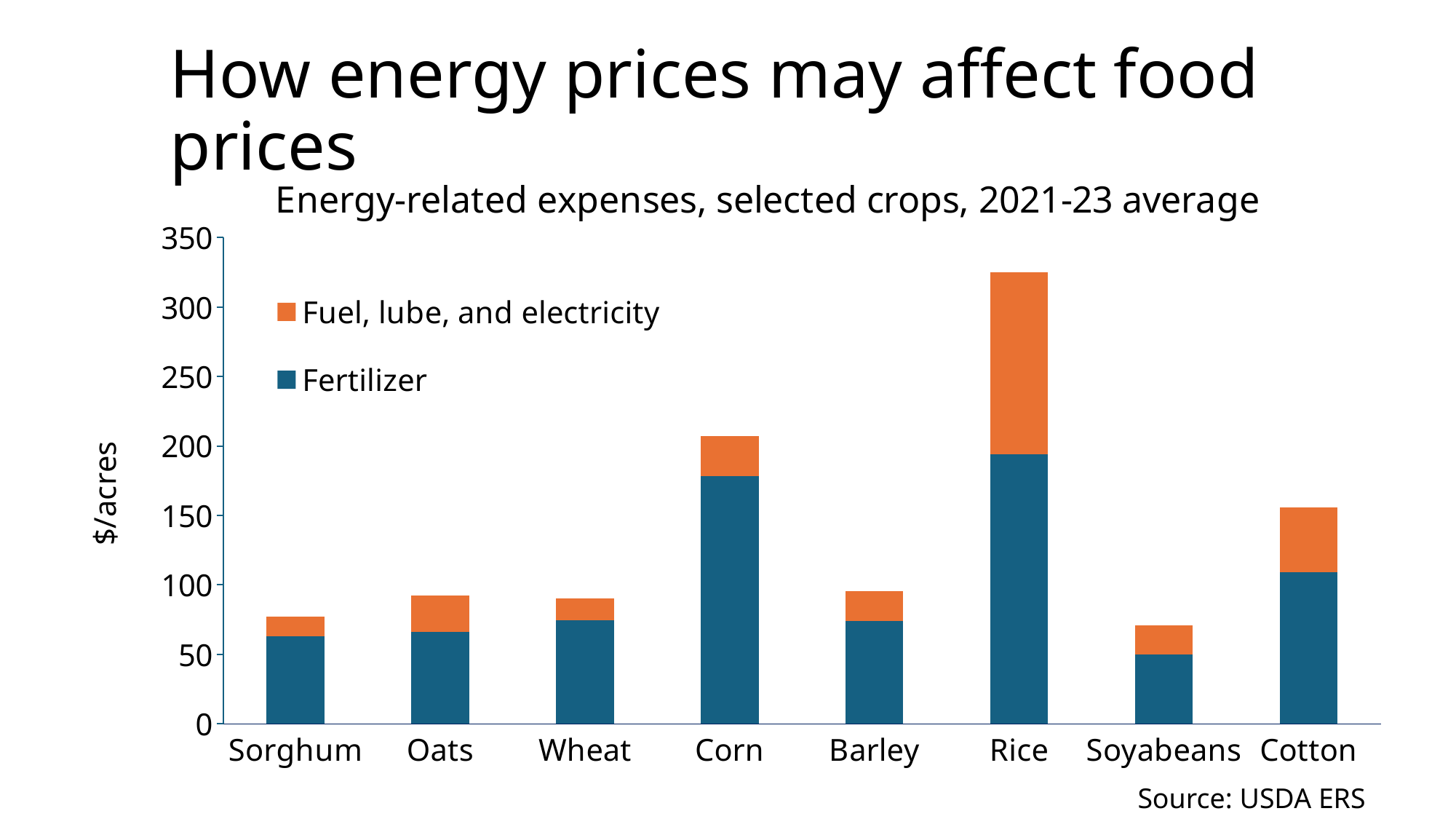
Is the total bar for Soyabeans greater or less than 100? less How many series does the legend list? 2 What kind of chart is shown on the slide? Bar chart Which has a larger total bar, Corn or Cotton? Corn Which crop has the highest total energy-related expenses? Rice Which crop has the highest Fertilizer expense? Rice Is the total bar for Rice greater or less than 300? greater Which crop has the lowest Fertilizer expense? Soyabeans Which series is shown in orange? Fuel, lube, and electricity What is the label on the y axis? $/acres How many crops are shown on the x axis? 8 Is the Fertilizer value for Corn greater or less than 150? greater